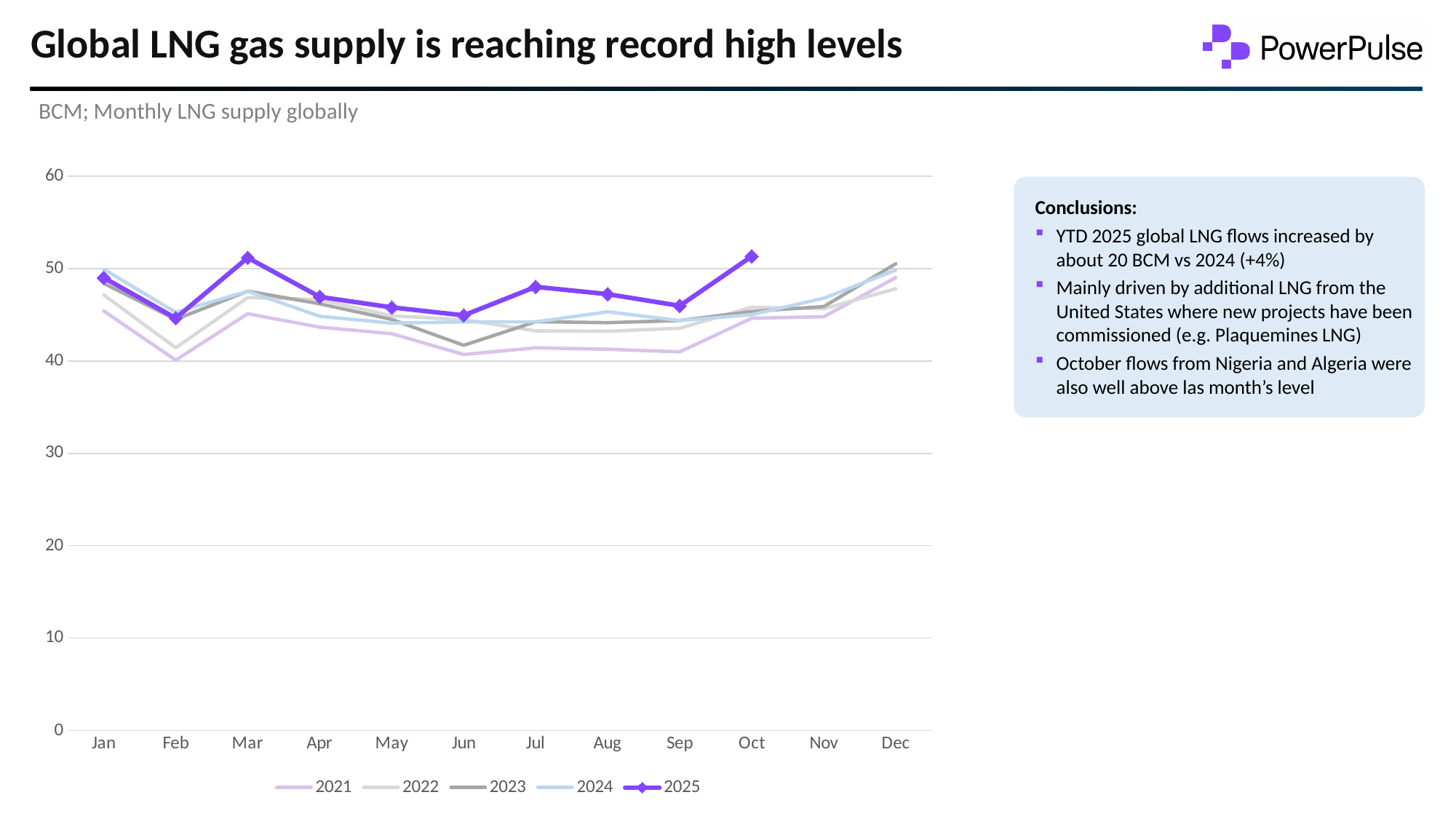
What is the last month for which the 2025 series has a data point? Oct Is the 2025 value for Oct greater or less than 50? greater Is the 2021 value for Feb greater or less than 45? less How many series does the legend list? 5 Is the 2025 value for Mar greater or less than 50? greater Which is larger in Jul, the 2025 value or the 2021 value? 2025 Do the 2025 values rise or fall from Jul to Sep? fall What kind of chart is shown on the slide? line chart How many months are shown along the x axis? 12 Do the 2021 values rise or fall from Sep to Dec? rise Which series has the highest value in Oct? 2025